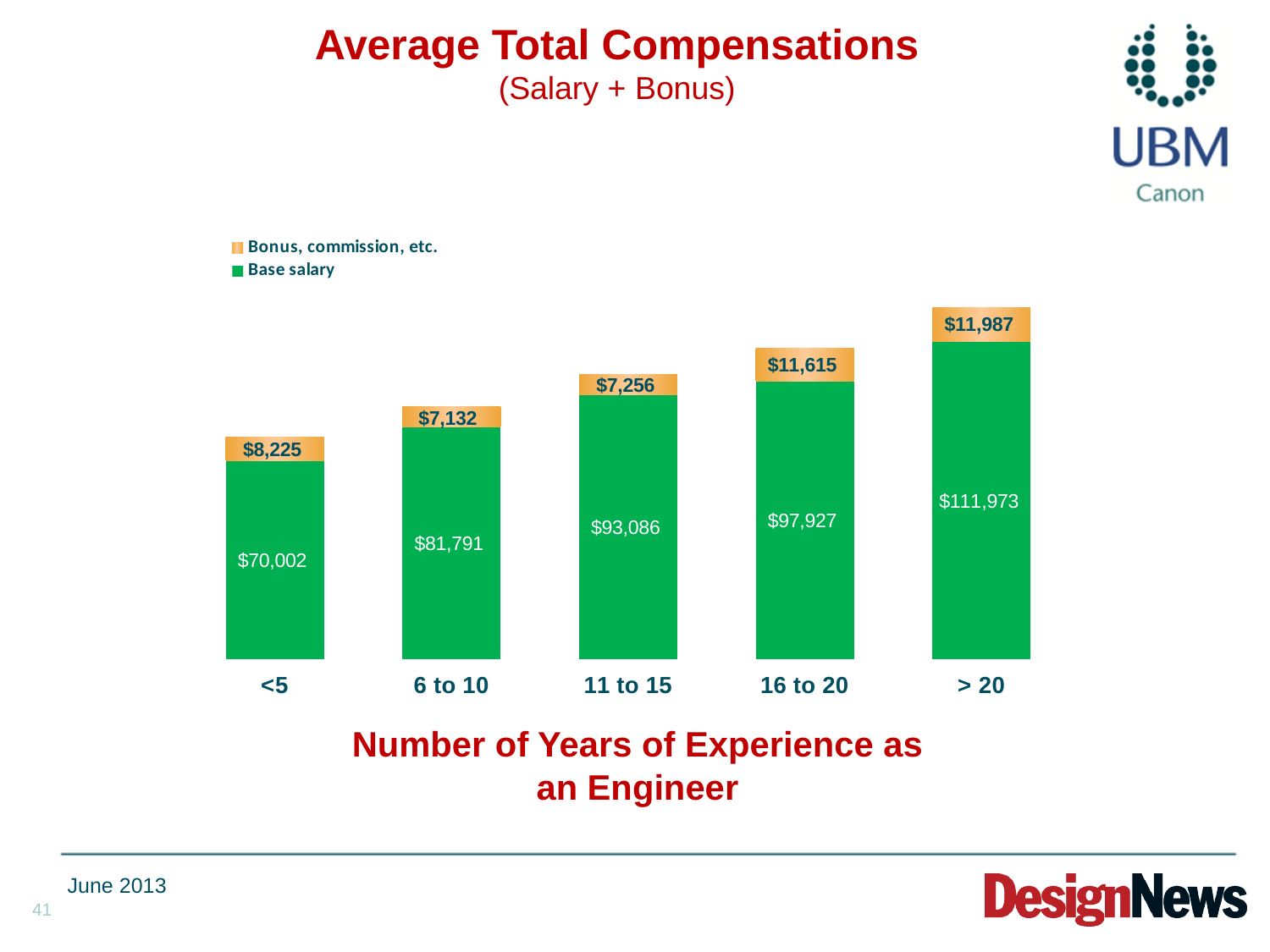
How many series does the legend list? 2 Which experience group has the lowest bonus, commission, etc. value? 6 to 10 How many experience groups are shown on the x axis? 5 Which experience group has the highest base salary? > 20 What is the base salary for engineers with 6 to 10 years of experience? $81,791 What is the difference in base salary between the > 20 group and the <5 group? $41,971 What is the total compensation (base salary plus bonus) for the 11 to 15 group? $100,342 Does base salary rise or fall as years of experience increase along the x axis? Rise Which is larger, the bonus for the <5 group or the bonus for the 11 to 15 group? <5 What kind of chart is shown on the slide? Stacked bar chart What is the base salary for engineers with more than 20 years of experience? $111,973 What is the bonus, commission, etc. value for engineers with 16 to 20 years of experience? $11,615